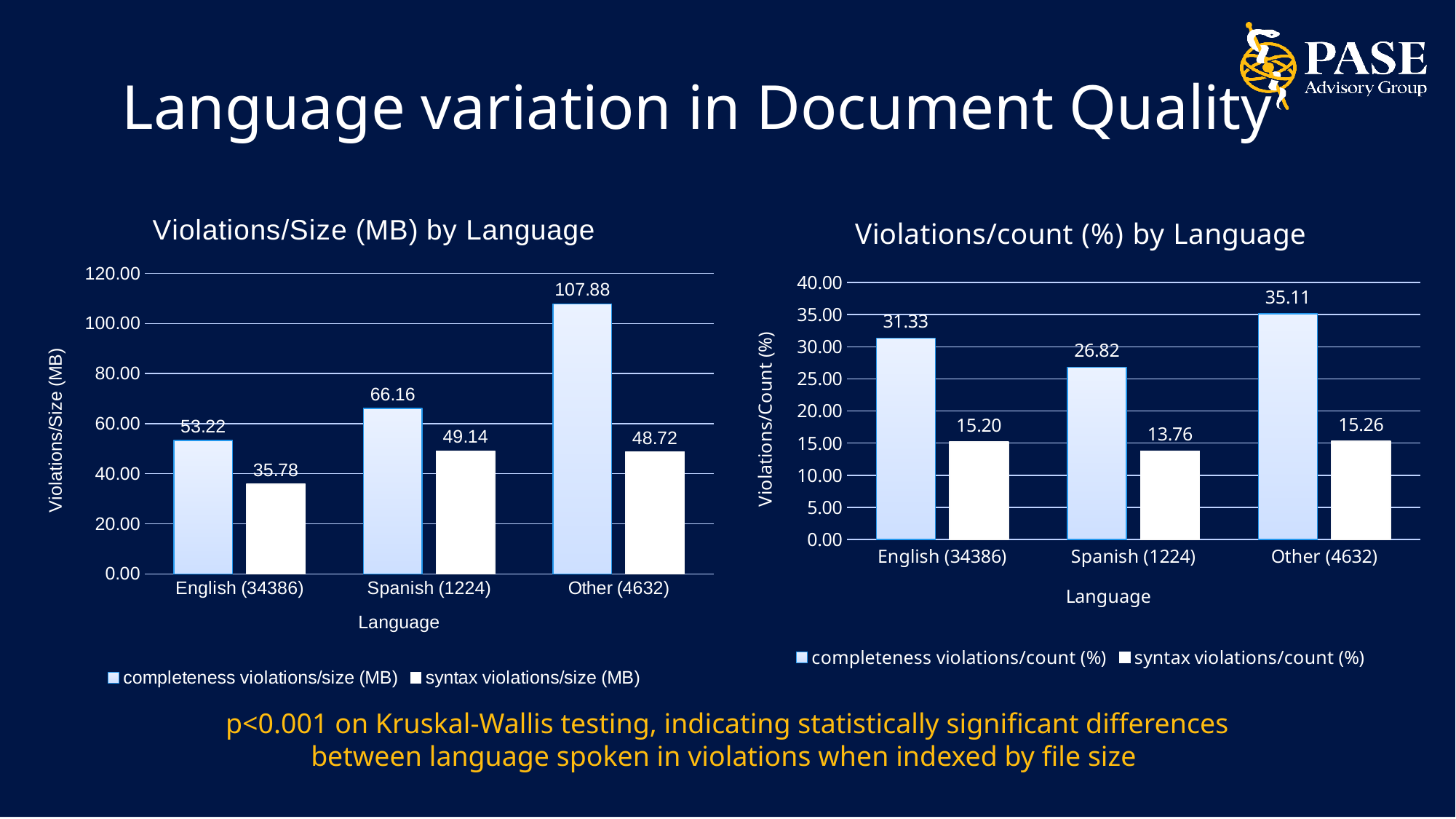
In the 'Violations/Size (MB) by Language' chart, what is the difference between the completeness and syntax violations/size (MB) for Spanish (1224)? 17.02 In the 'Violations/Size (MB) by Language' chart, what is the syntax violations/size (MB) value for English (34386)? 35.78 In the 'Violations/count (%) by Language' chart, which language has the lowest syntax violations/count (%)? Spanish (1224) In the 'Violations/Size (MB) by Language' chart, what is the completeness violations/size (MB) value for Other (4632)? 107.88 In the 'Violations/Size (MB) by Language' chart, which language has the highest completeness violations/size (MB)? Other (4632) In the 'Violations/count (%) by Language' chart, what is the syntax violations/count (%) value for Other (4632)? 15.26 What kind of chart is the 'Violations/count (%) by Language' chart? Bar chart In the 'Violations/count (%) by Language' chart, what is the difference between the completeness violations/count (%) for Other (4632) and English (34386)? 3.78 How many language categories are shown in the 'Violations/count (%) by Language' chart? 3 How many series does the legend of the 'Violations/Size (MB) by Language' chart list? 2 In the 'Violations/count (%) by Language' chart, what is the completeness violations/count (%) value for Spanish (1224)? 26.82 In the 'Violations/Size (MB) by Language' chart, which is larger: the syntax violations/size (MB) for Spanish (1224) or for Other (4632)? Spanish (1224)